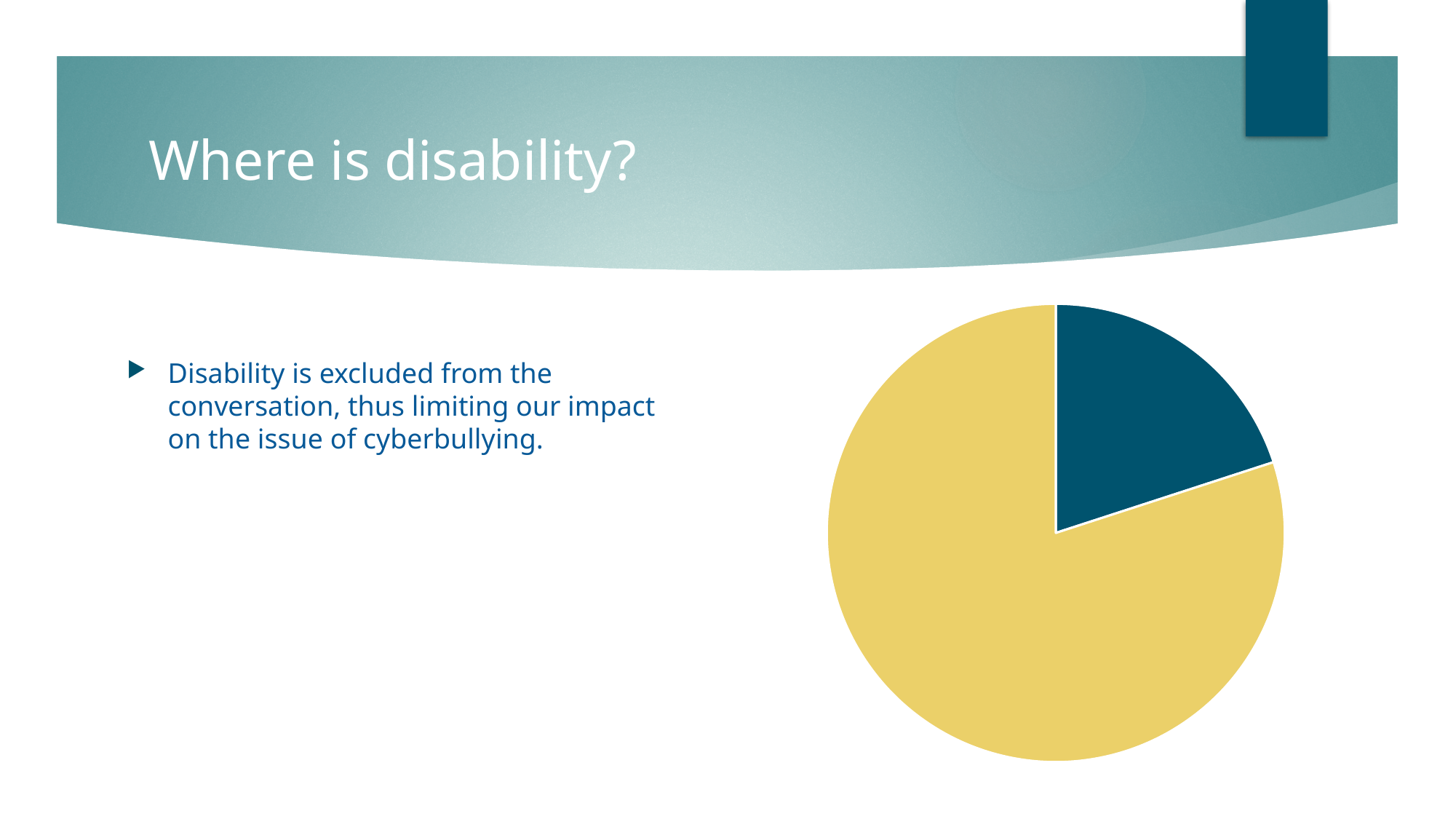
What kind of chart is shown on the slide? pie chart How many slices does the pie chart have? 2 What colour is the smaller slice of the pie chart? dark blue Which slice of the pie chart is larger, the yellow one or the dark blue one? the yellow one Which slice of the pie chart is smaller, the yellow one or the dark blue one? the dark blue one Does the pie chart display a legend? No